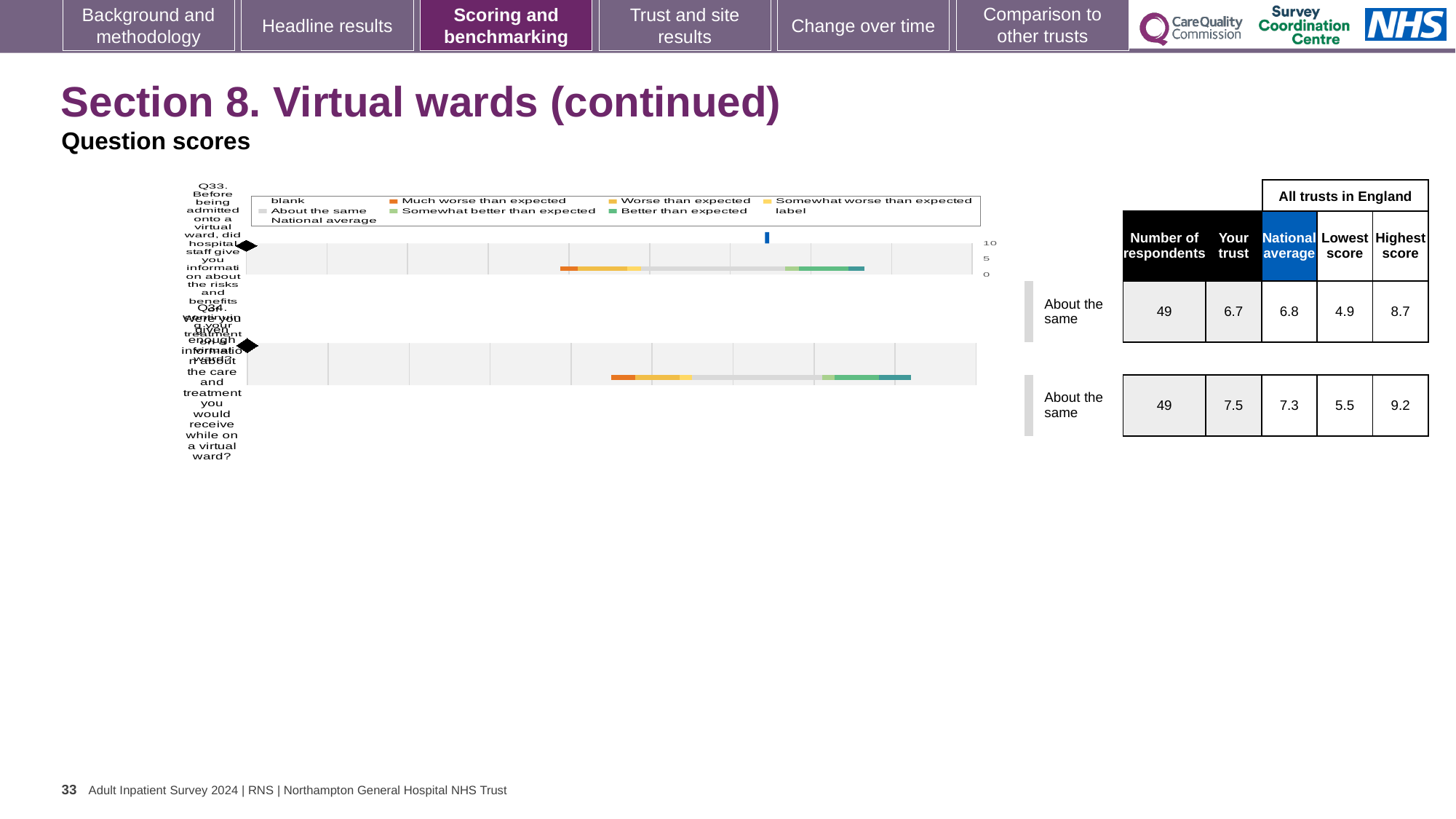
According to the table beside the chart, how many respondents answered Q34? 49 According to the table beside the chart, what is the national average for Q34? 7.3 What benchmark category is shown next to both Q33 and Q34 in the chart? About the same According to the table beside the chart, what is the 'Your trust' score for Q33? 6.7 In the chart legend, what colour represents 'Much worse than expected'? orange In the chart legend, what colour represents 'About the same'? grey For Q34, what is the difference between the highest score and the lowest score in the table? 3.7 For Q34, which is larger: the 'Your trust' score or the national average? Your trust What kind of chart is shown on the slide for the question scores? bar chart How many questions (bars) are plotted in the chart? 2 According to the table beside the chart, what is the highest score for Q33? 8.7 For Q33, what is the difference between the national average and the 'Your trust' score? 0.1